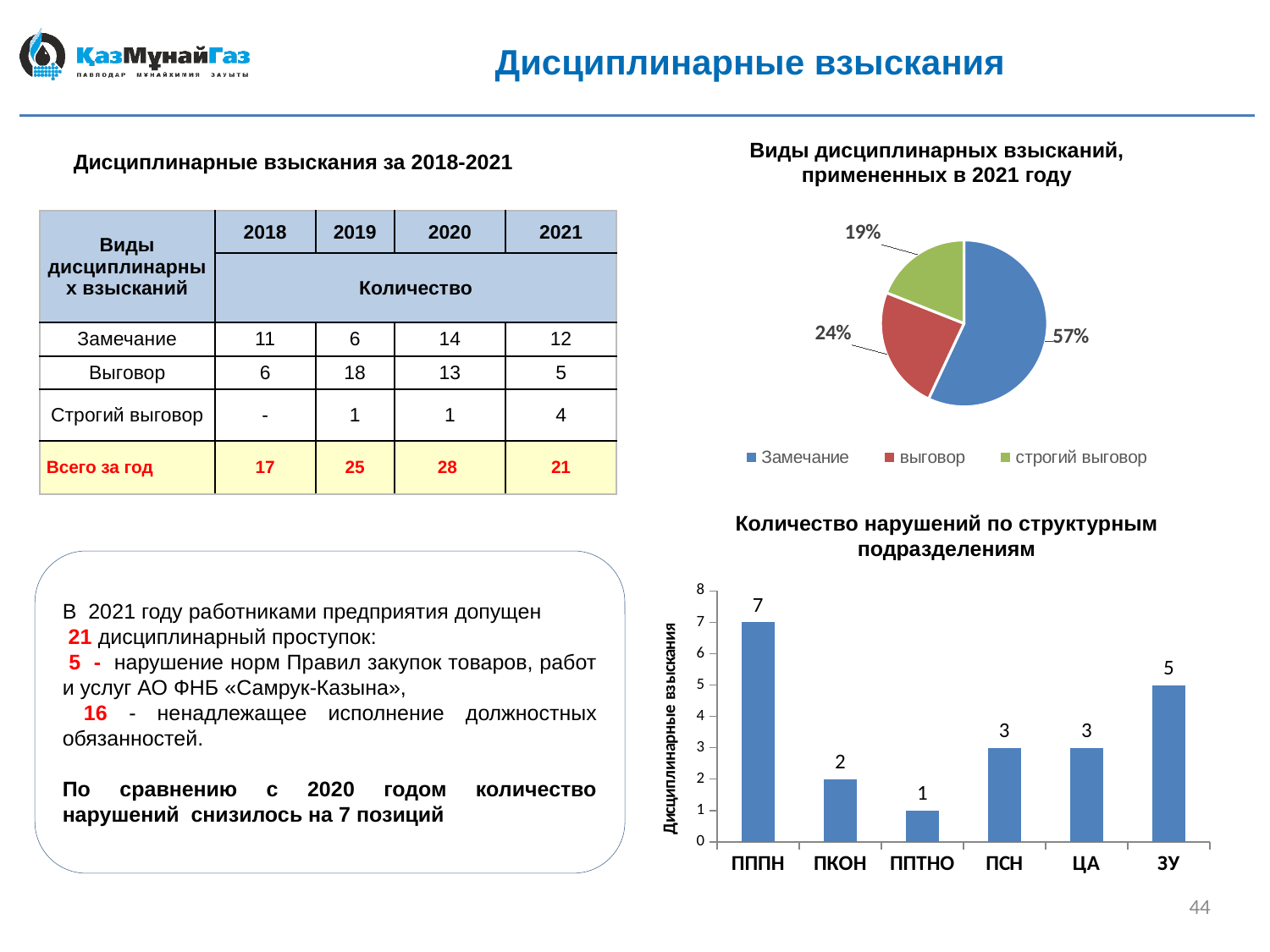
In the pie chart 'Виды дисциплинарных взысканий, примененных в 2021 году', what share does 'Замечание' have? 57% In the pie chart 'Виды дисциплинарных взысканий, примененных в 2021 году', what share does 'строгий выговор' have? 19% In the bar chart 'Количество нарушений по структурным подразделениям', what is the value for ПППН? 7 In the bar chart 'Количество нарушений по структурным подразделениям', which is larger, ПСН or ЗУ? ЗУ In the pie chart 'Виды дисциплинарных взысканий, примененных в 2021 году', which category has the largest share? Замечание What kind of chart is 'Количество нарушений по структурным подразделениям'? bar chart In the bar chart 'Количество нарушений по структурным подразделениям', what is the value for ЗУ? 5 In the pie chart 'Виды дисциплинарных взысканий, примененных в 2021 году', what is the difference in percentage points between 'выговор' and 'строгий выговор'? 5 In the bar chart 'Количество нарушений по структурным подразделениям', how many categories are shown on the x axis? 6 In the pie chart 'Виды дисциплинарных взысканий, примененных в 2021 году', how many categories does the legend list? 3 In the bar chart 'Количество нарушений по структурным подразделениям', which category has the lowest value? ППТНО In the bar chart 'Количество нарушений по структурным подразделениям', what is the difference between ПППН and ПКОН? 5